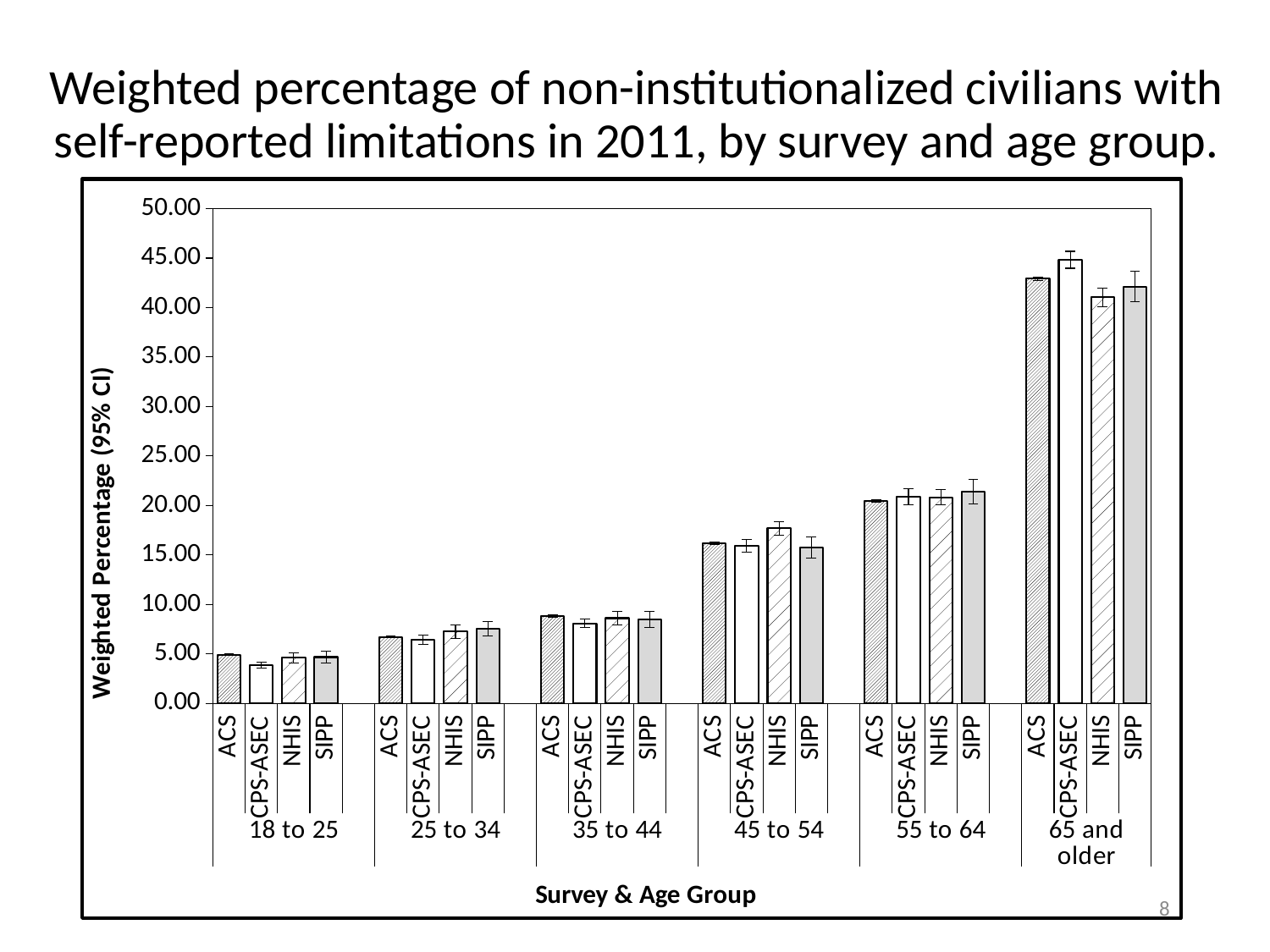
Is the value for NHIS in the 45 to 54 group greater or less than 15.00? greater Is the value for SIPP in the 55 to 64 group greater or less than 25.00? less Is the value for CPS-ASEC in the 65 and older group greater or less than 40.00? greater Which age group has the highest weighted percentages? 65 and older Which age group has the lowest weighted percentages? 18 to 25 Do the weighted percentages rise or fall as the age groups get older along the x axis? rise In the 65 and older group, which is larger, the value for CPS-ASEC or the value for NHIS? CPS-ASEC How many surveys are plotted within each age group? 4 How many age groups are shown along the x axis? 6 What kind of chart is shown on the slide? bar chart